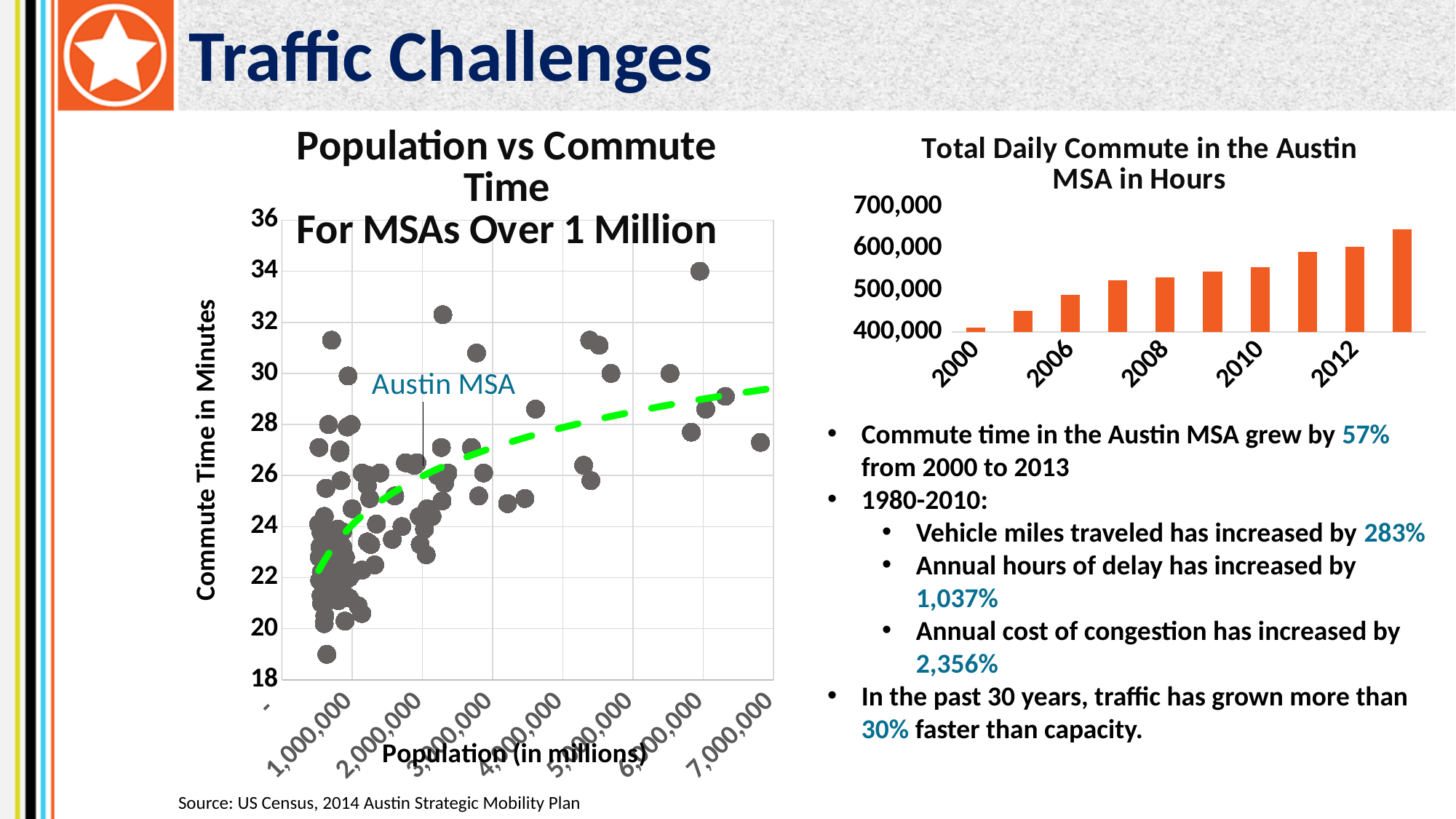
In the 'Total Daily Commute in the Austin MSA in Hours' chart, is the tallest bar the leftmost or the rightmost bar? rightmost In the 'Total Daily Commute in the Austin MSA in Hours' chart, which is larger, the value for 2006 or the value for 2012? 2012 What kind of chart is the 'Population vs Commute Time For MSAs Over 1 Million' chart? scatter chart In the 'Total Daily Commute in the Austin MSA in Hours' chart, is the value for 2012 greater or less than 500,000? greater In the 'Total Daily Commute in the Austin MSA in Hours' chart, do the bars generally rise or fall from left to right? rise In the 'Population vs Commute Time For MSAs Over 1 Million' chart, is the commute time for the Austin MSA point greater or less than 24 minutes? greater In the 'Total Daily Commute in the Austin MSA in Hours' chart, how many bars are plotted? 10 In the 'Population vs Commute Time For MSAs Over 1 Million' chart, is the highest plotted point greater or less than 32 minutes? greater What kind of chart is the 'Total Daily Commute in the Austin MSA in Hours' chart? bar chart In the 'Population vs Commute Time For MSAs Over 1 Million' chart, does the dashed trend line rise or fall as population increases? rise What is the y-axis title of the 'Population vs Commute Time For MSAs Over 1 Million' chart? Commute Time in Minutes